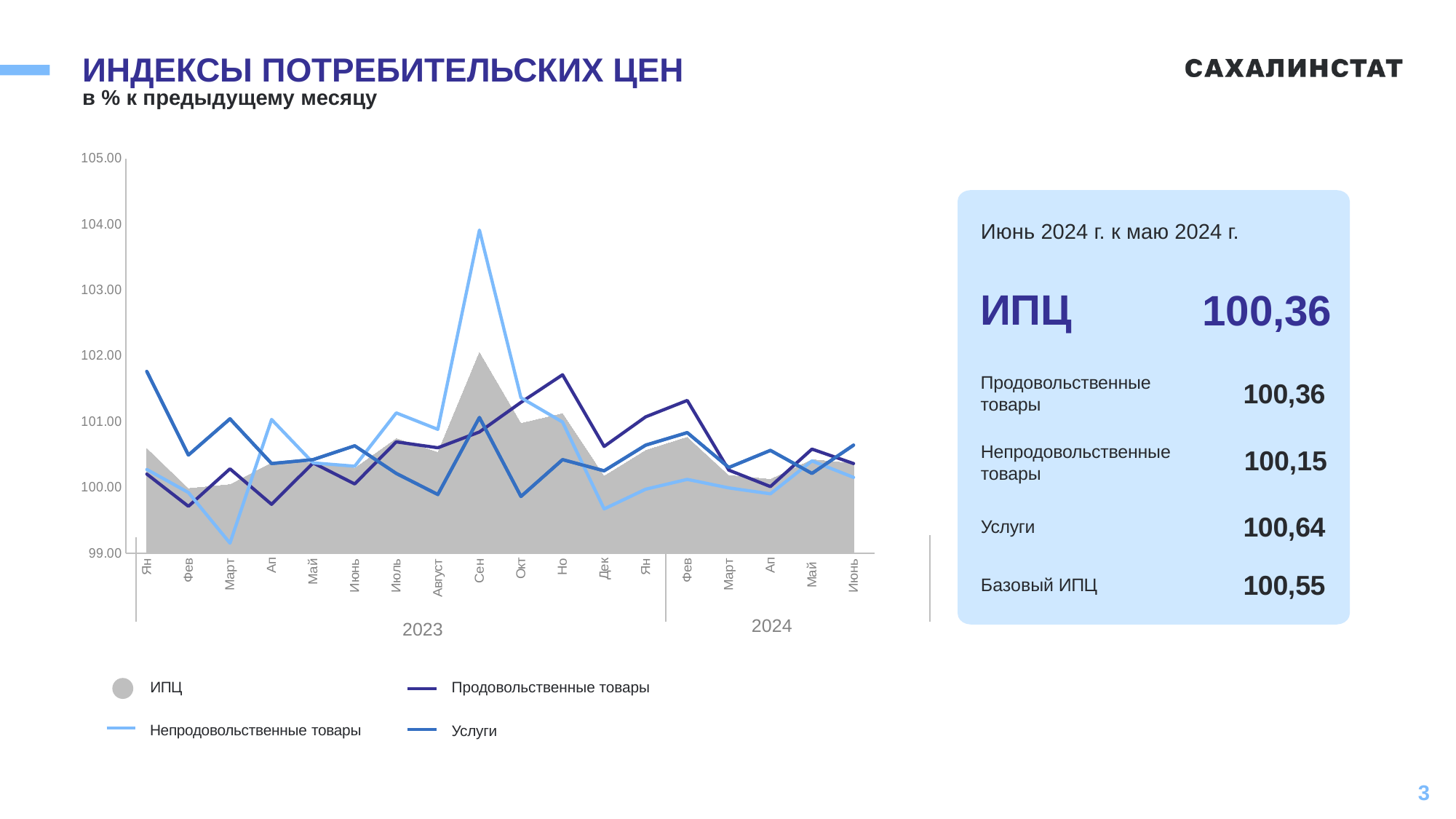
In the panel for Июнь 2024 к маю 2024, what is the difference between Услуги and Непродовольственные товары? 0,49 Is the value for Продовольственные товары in Ян 2023 greater or less than 101.00? less Is the value for Услуги in Ян 2023 greater or less than 101.00? greater According to the panel for Июнь 2024 к маю 2024, what is the value of ИПЦ? 100,36 In which month does the Непродовольственные товары line reach its highest value? Сен 2023 In the panel for Июнь 2024 к маю 2024, which is larger: Услуги or Продовольственные товары? Услуги How many months are plotted along the x axis of the chart? 18 In which month does the Непродовольственные товары line reach its lowest value? Март 2023 Is the value for Непродовольственные товары in Сен 2023 greater or less than 103.00? greater According to the panel for Июнь 2024 к маю 2024, what is the value for Услуги? 100,64 What kind of chart is shown on the slide? line chart with a shaded area How many series does the chart legend list? 4